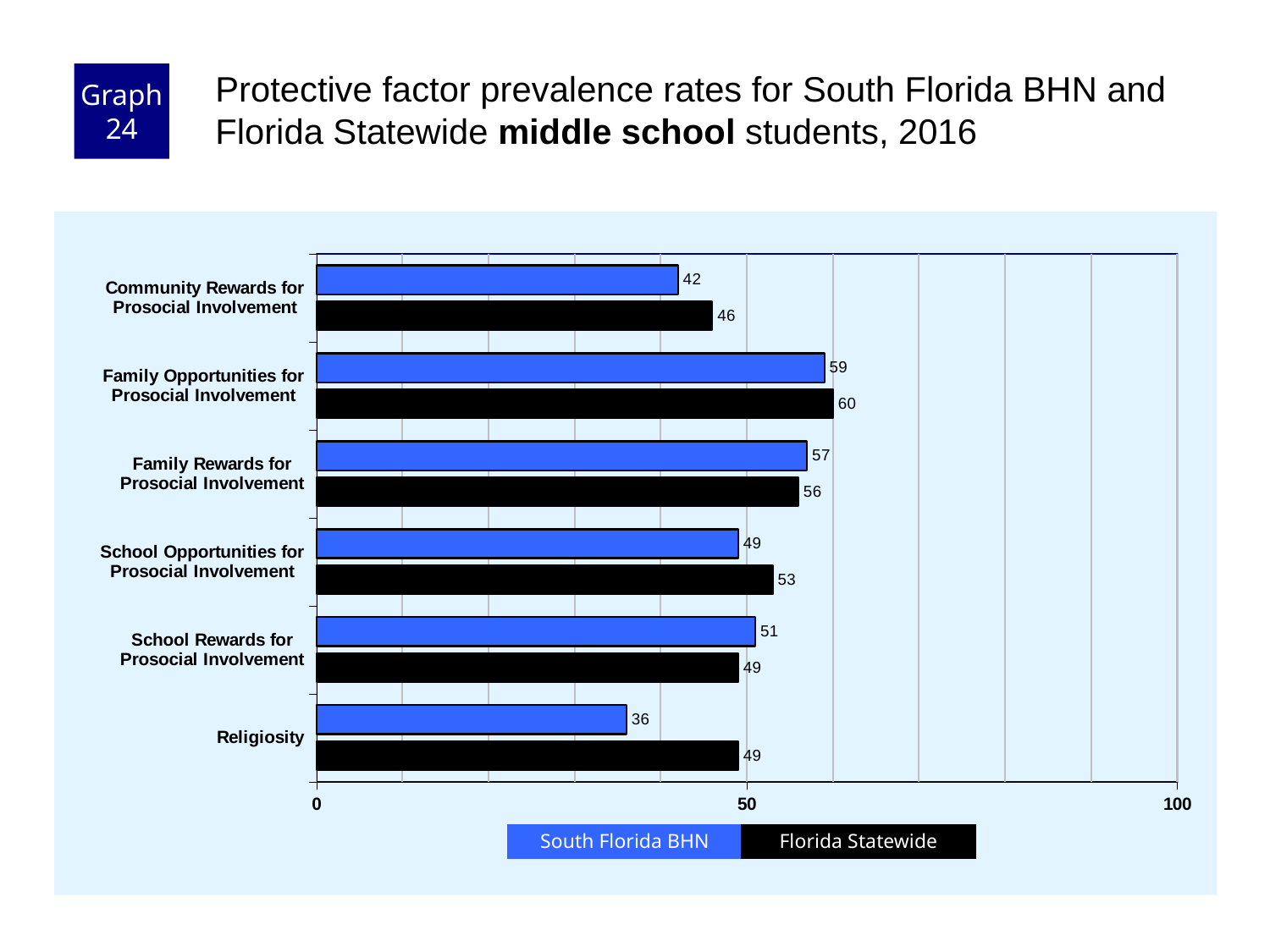
Which series is shown in black? Florida Statewide How many categories are shown on the chart? 6 Is the South Florida BHN value for Family Rewards for Prosocial Involvement greater or less than 50? greater What kind of chart is shown on the slide? bar chart Which category has the highest Florida Statewide value? Family Opportunities for Prosocial Involvement What is the South Florida BHN value for Family Opportunities for Prosocial Involvement? 59 Which is larger for Community Rewards for Prosocial Involvement: South Florida BHN or Florida Statewide? Florida Statewide What is the Florida Statewide value for School Opportunities for Prosocial Involvement? 53 What is the South Florida BHN value for Religiosity? 36 How many series does the legend list? 2 Which category has the lowest South Florida BHN value? Religiosity What is the difference between the Florida Statewide and South Florida BHN values for Religiosity? 13